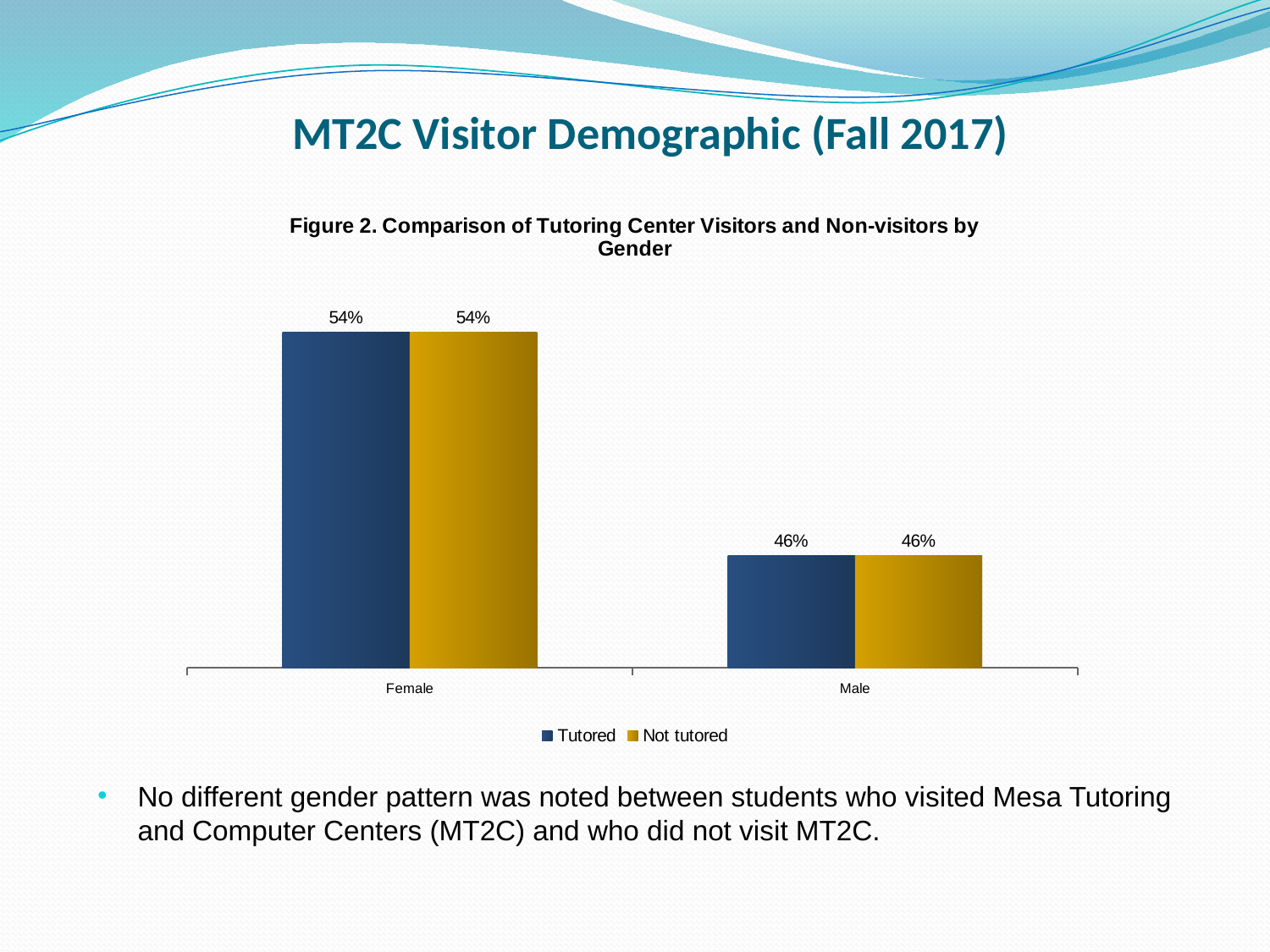
What is the difference between the Tutored values for Female and Male? 8% What is the Tutored value for Female? 54% How many series does the legend list? 2 Which category has the lowest Not tutored value? Male What kind of chart is shown? bar chart What is the Tutored value for Male? 46% What is the Not tutored value for Male? 46% Which category has the highest Tutored value? Female How many categories are shown on the x axis? 2 What is the title of the chart? Figure 2. Comparison of Tutoring Center Visitors and Non-visitors by Gender Is the Tutored value for Female larger or smaller than the Tutored value for Male? larger What is the Not tutored value for Female? 54%